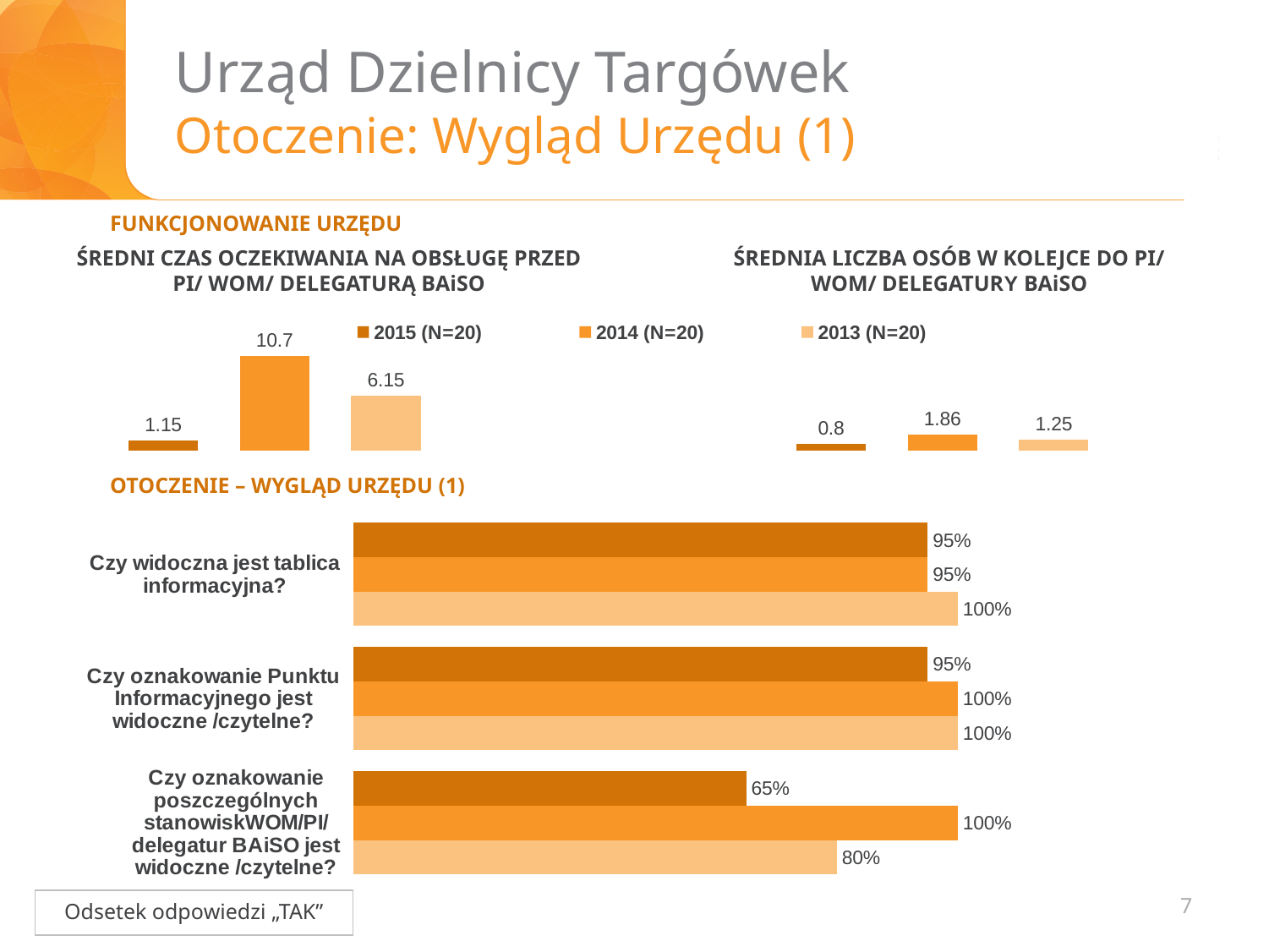
In the bottom chart 'OTOCZENIE – WYGLĄD URZĘDU (1)', what is the 2015 value for 'Czy oznakowanie poszczególnych stanowisk WOM/PI/ delegatur BAiSO jest widoczne /czytelne?'? 65% In the chart 'ŚREDNI CZAS OCZEKIWANIA NA OBSŁUGĘ PRZED PI/ WOM/ DELEGATURĄ BAiSO', what is the value for 2014 (N=20)? 10.7 In the chart 'ŚREDNIA LICZBA OSÓB W KOLEJCE DO PI/ WOM/ DELEGATURY BAiSO', what is the value for 2013 (N=20)? 1.25 In the chart 'ŚREDNI CZAS OCZEKIWANIA NA OBSŁUGĘ PRZED PI/ WOM/ DELEGATURĄ BAiSO', which year has the lowest value? 2015 (N=20) How many question categories are shown in the bottom chart 'OTOCZENIE – WYGLĄD URZĘDU (1)'? 3 What type of chart is the bottom chart 'OTOCZENIE – WYGLĄD URZĘDU (1)'? bar chart In the chart 'ŚREDNI CZAS OCZEKIWANIA NA OBSŁUGĘ PRZED PI/ WOM/ DELEGATURĄ BAiSO', what is the difference between the 2014 and 2013 values? 4.55 In the chart 'ŚREDNIA LICZBA OSÓB W KOLEJCE DO PI/ WOM/ DELEGATURY BAiSO', which year has the highest value? 2014 (N=20) In the bottom chart 'OTOCZENIE – WYGLĄD URZĘDU (1)', what is the difference between the 2014 and 2013 values for 'Czy oznakowanie poszczególnych stanowisk WOM/PI/ delegatur BAiSO jest widoczne /czytelne?'? 20% In the bottom chart 'OTOCZENIE – WYGLĄD URZĘDU (1)', what is the 2013 value for 'Czy widoczna jest tablica informacyjna?'? 100% How many series does the legend list for the charts on the slide? 3 In the chart 'ŚREDNIA LICZBA OSÓB W KOLEJCE DO PI/ WOM/ DELEGATURY BAiSO', is the value for 2015 larger or smaller than the value for 2013? smaller